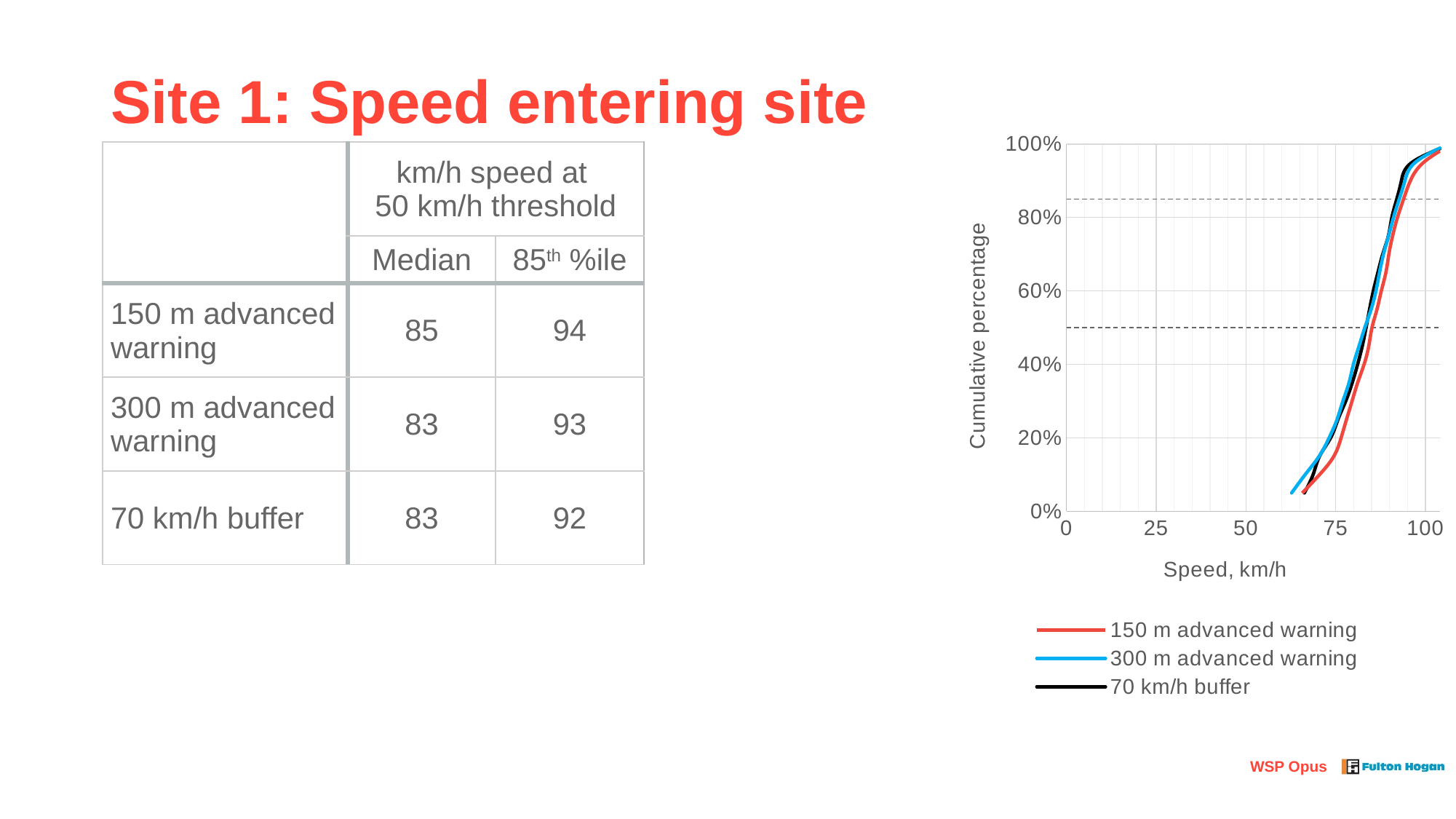
In the cumulative percentage chart, is the value for 150 m advanced warning at 100 km/h greater or less than 80%? greater In the cumulative percentage chart, is the value for 300 m advanced warning at 75 km/h greater or less than 60%? less What is the label of the x axis of the cumulative percentage chart? Speed, km/h In the cumulative percentage chart, is the value for 70 km/h buffer at 75 km/h greater or less than 60%? less How many series does the legend of the cumulative percentage chart list? 3 What kind of chart is shown on the right of the slide? line chart In the cumulative percentage chart, do the lines rise or fall as speed increases along the x axis? rise Which series is drawn in red in the cumulative percentage chart? 150 m advanced warning